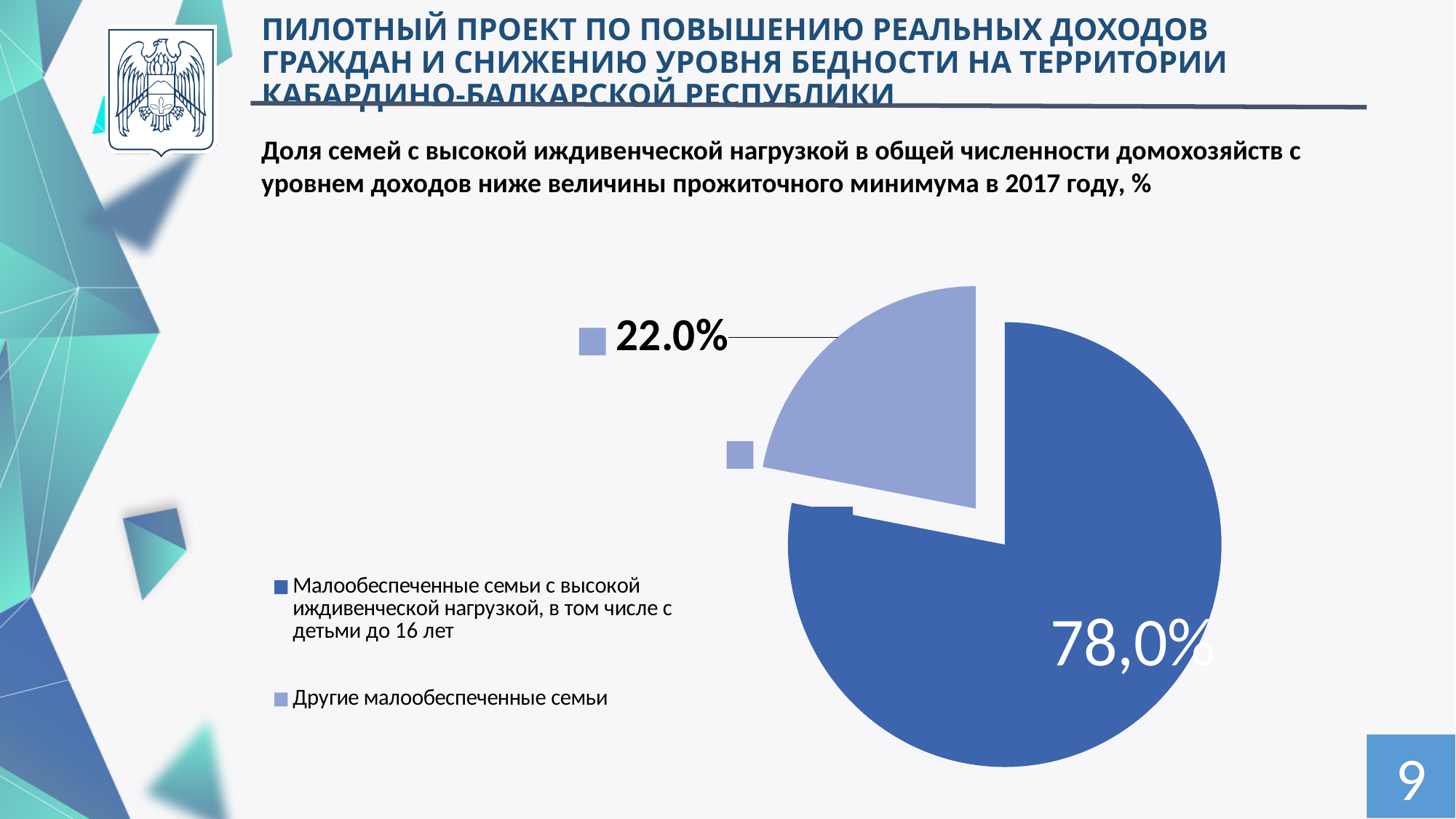
What colour is the slice for 'Другие малообеспеченные семьи'? light blue Which is larger: the slice for 'Малообеспеченные семьи с высокой иждивенческой нагрузкой' or the slice for 'Другие малообеспеченные семьи'? Малообеспеченные семьи с высокой иждивенческой нагрузкой What share of the pie is labelled for 'Малообеспеченные семьи с высокой иждивенческой нагрузкой, в том числе с детьми до 16 лет'? 78,0% Which year does the chart title refer to? 2017 Which slice of the pie is the smallest? Другие малообеспеченные семьи What share of the pie is labelled for 'Другие малообеспеченные семьи'? 22.0% How many slices does the pie chart have? 2 Is the share for 'Другие малообеспеченные семьи' greater or less than 50%? less How many entries does the legend list? 2 Which slice of the pie is the largest? Малообеспеченные семьи с высокой иждивенческой нагрузкой, в том числе с детьми до 16 лет What kind of chart is shown on the slide? pie chart